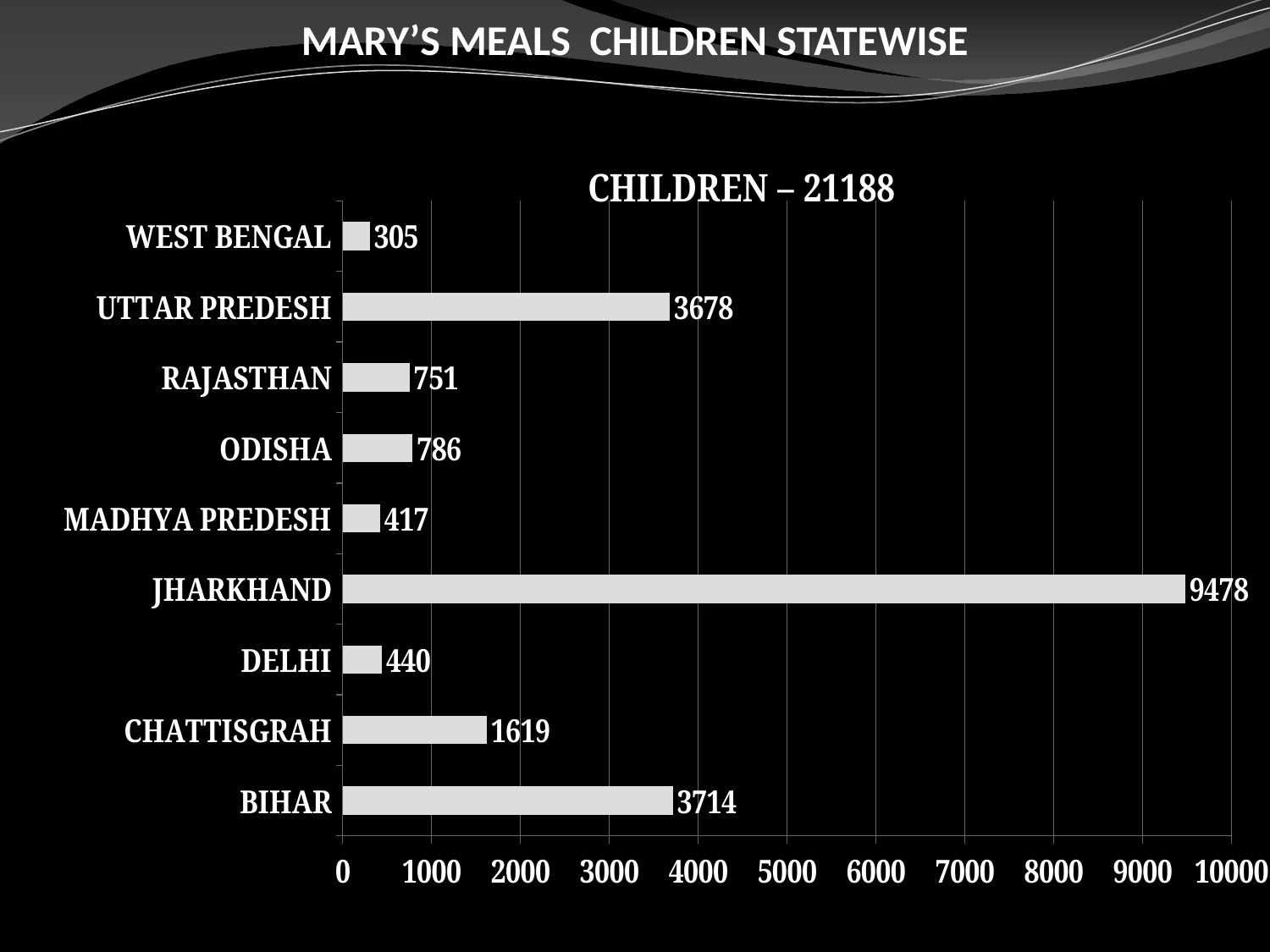
What is the value for Chattisgrah? 1619 Is the value for Chattisgrah greater or less than 2000? less What is the difference between the values for Odisha and Rajasthan? 35 How many children are shown for Jharkhand? 9478 What is the title of the chart? CHILDREN – 21188 Which is larger, the value for Delhi or the value for Madhya Predesh? Delhi What is the value for Uttar Predesh? 3678 What kind of chart is shown on the slide? bar chart Which state has the highest number of children? Jharkhand What is the difference between the values for Bihar and Uttar Predesh? 36 How many states are shown on the chart? 9 Which state has the lowest number of children? West Bengal